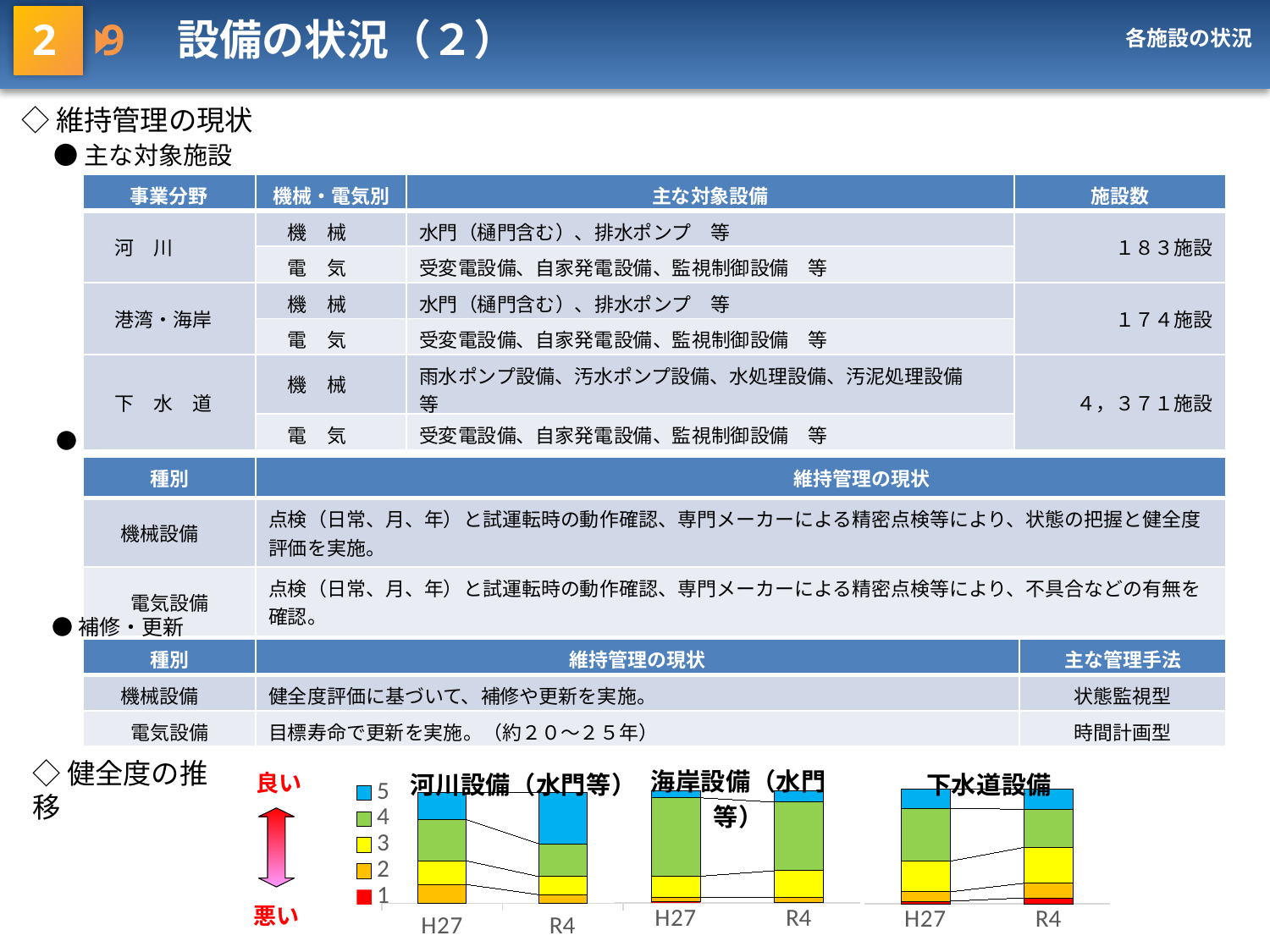
What are the two x-axis categories of the 海岸設備（水門等） chart? H27 and R4 How many series does the legend next to the 河川設備（水門等） chart list? 5 What kind of chart is the 河川設備（水門等） chart? stacked bar chart In the 河川設備（水門等） chart, does the share of the blue (5) segment rise or fall from H27 to R4? rise Which legend entry is shown in red in the charts? 1 In the 河川設備（水門等） chart, is the green (4) segment larger for H27 or for R4? H27 How many categories are on the x axis of the 下水道設備 chart? 2 In the 河川設備（水門等） chart, is the blue (5) segment larger for H27 or for R4? R4 In the 下水道設備 chart, is the red (1) segment larger for H27 or for R4? R4 How many charts are shown in the 健全度の推移 section of the slide? 3 What is the title of the rightmost chart on the slide? 下水道設備